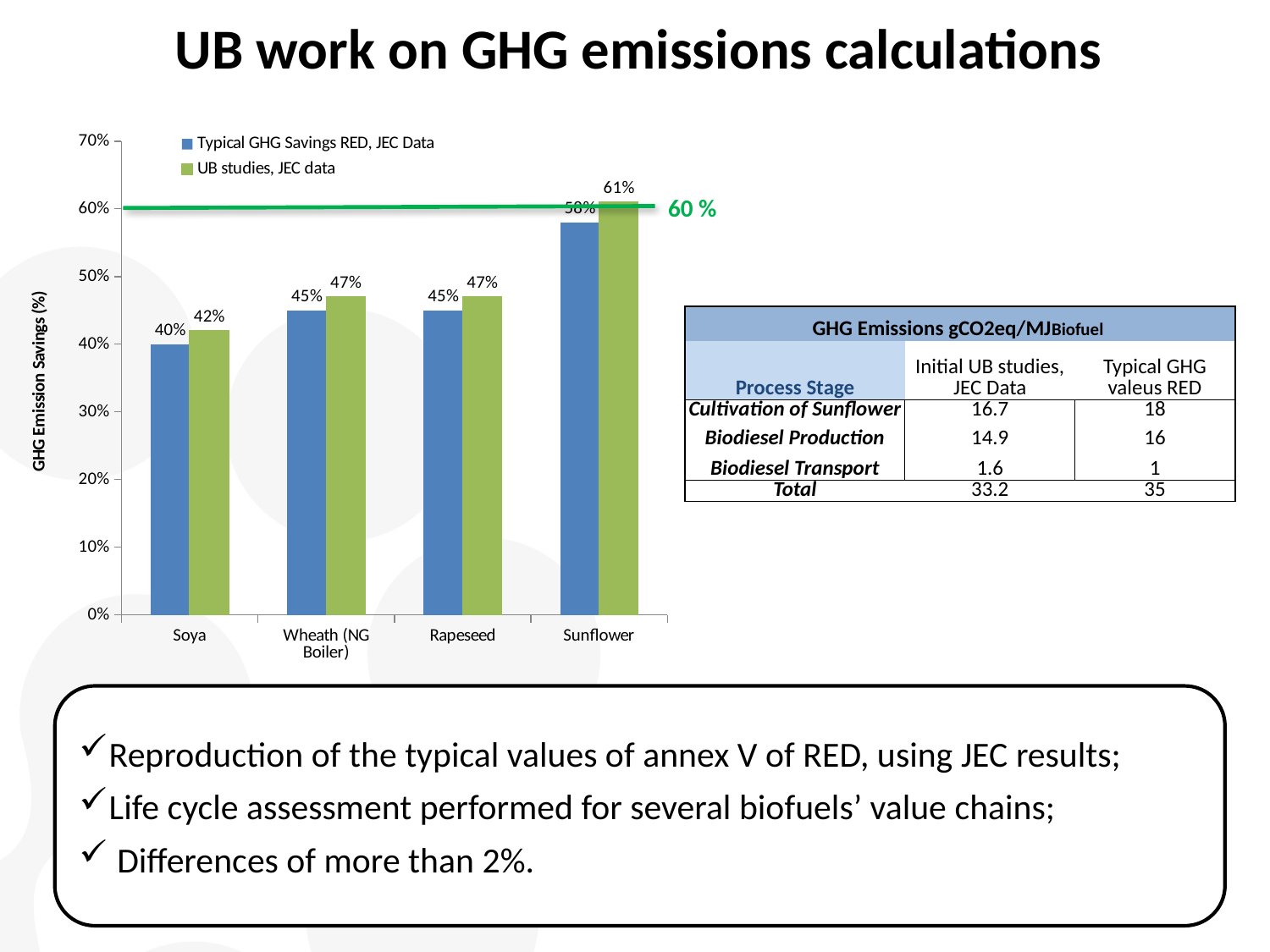
What is the label of the vertical axis of the chart? GHG Emission Savings (%) What is the difference between the 'UB studies, JEC data' value and the 'Typical GHG Savings RED, JEC Data' value for Sunflower? 3% What is the value for Rapeseed in the 'UB studies, JEC data' series? 47% For Wheath (NG Boiler), which series has the larger value: 'Typical GHG Savings RED, JEC Data' or 'UB studies, JEC data'? UB studies, JEC data How many series does the chart legend list? 2 What is the value for Sunflower in the 'UB studies, JEC data' series? 61% Which category has the highest value in the 'Typical GHG Savings RED, JEC Data' series? Sunflower Which category has the lowest value in the 'UB studies, JEC data' series? Soya What is the value for Soya in the 'Typical GHG Savings RED, JEC Data' series? 40% How many categories are shown on the x axis of the chart? 4 Is the 'Typical GHG Savings RED, JEC Data' value for Sunflower greater or less than 60%? less What kind of chart is shown on the slide? bar chart